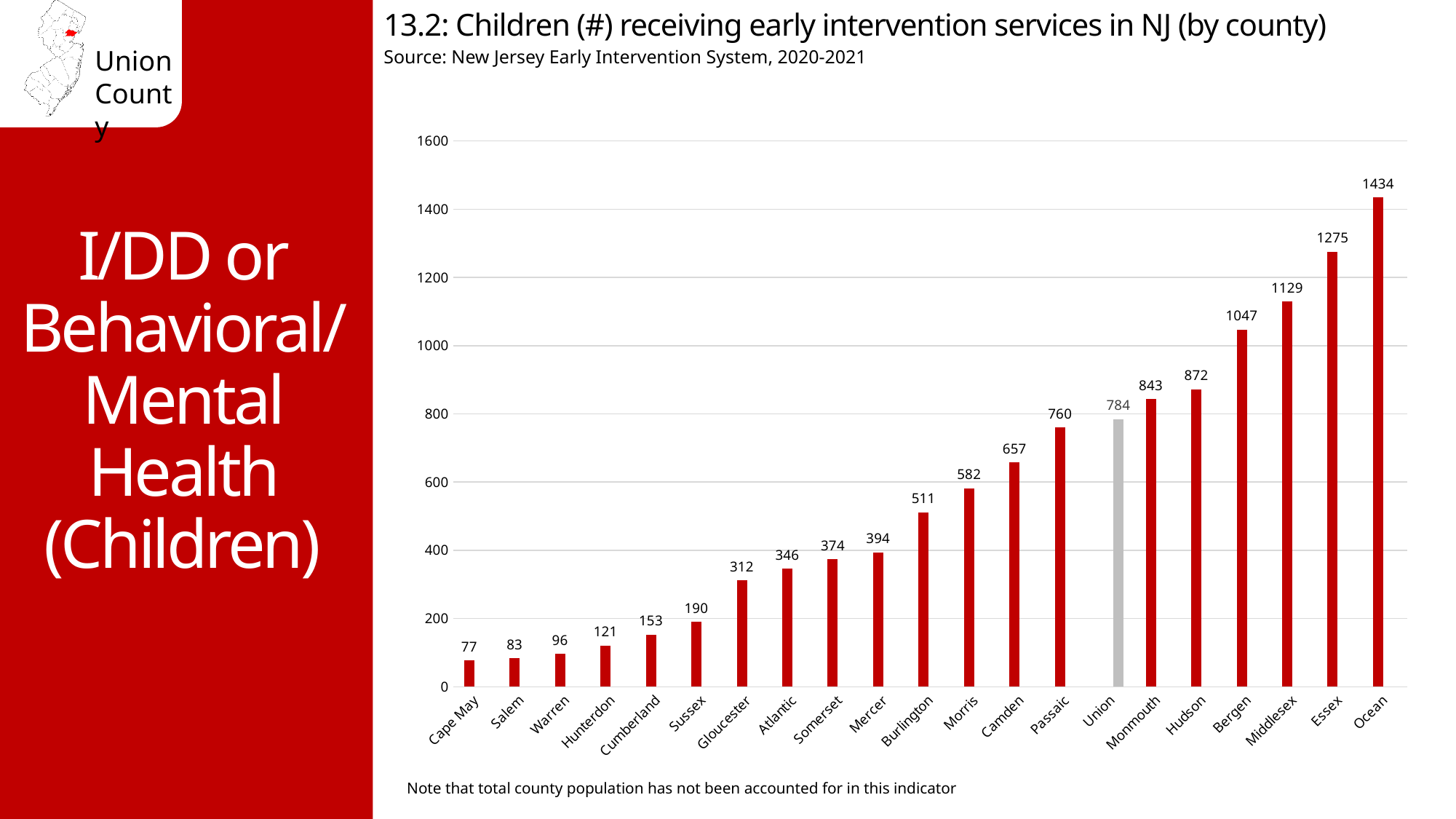
What is the value shown for Essex? 1275 Which county has the lowest number of children receiving early intervention services? Cape May Which has a larger value, Hudson or Monmouth? Hudson What kind of chart is shown on the slide? Bar chart How many children received early intervention services in Union County? 784 How many counties are shown on the x axis? 21 Is the value for Bergen greater or less than 1000? greater What is the value shown for Camden? 657 What is the difference between the values for Ocean and Union? 650 Which bar is coloured grey instead of red? Union Do the values rise or fall moving from left to right along the x axis? Rise Which county has the highest number of children receiving early intervention services? Ocean